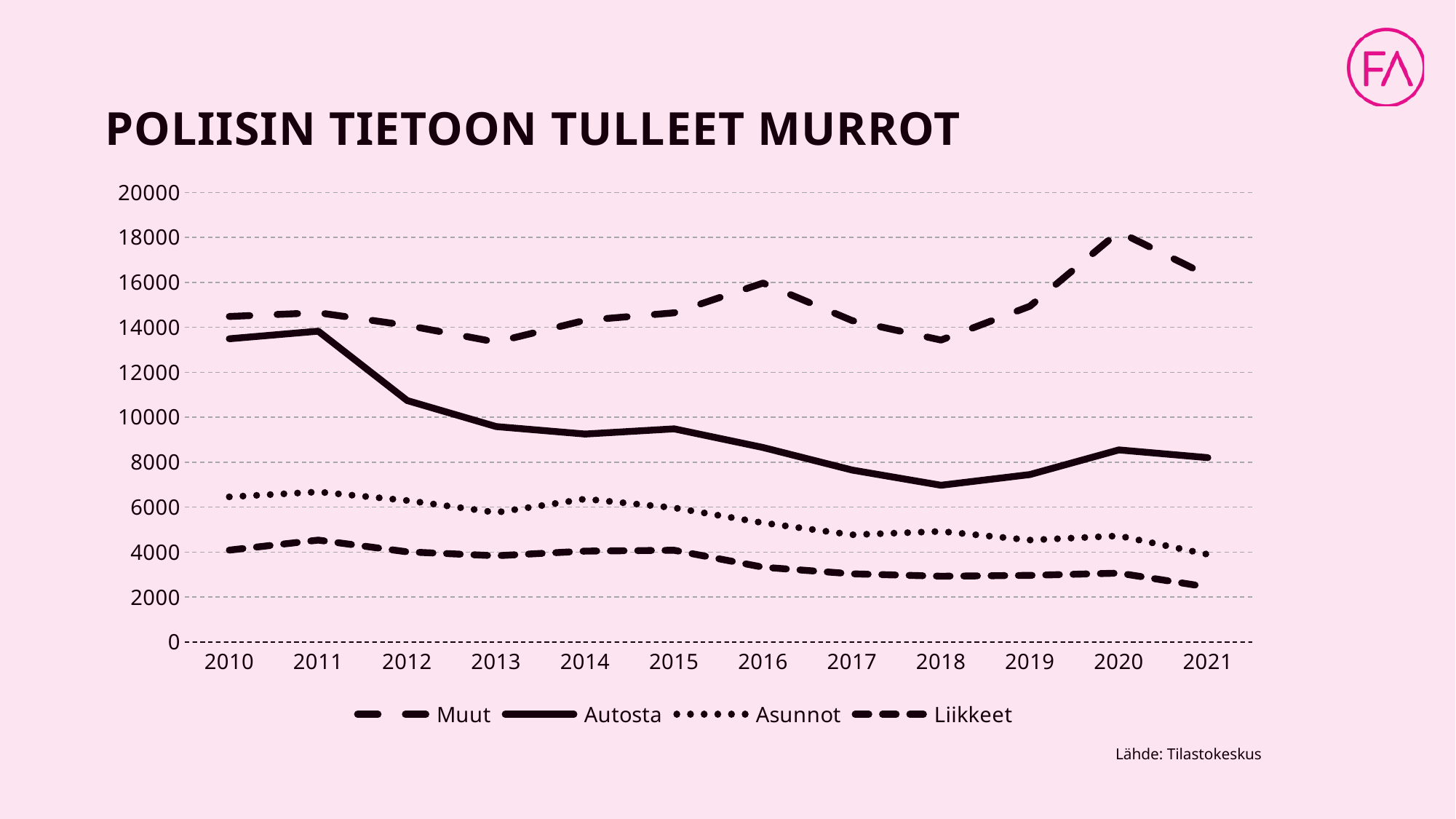
In which year does the Autosta series reach its lowest value? 2018 Which series has the lowest values across the whole period? Liikkeet In which year does the Muut series reach its highest value? 2020 How many series does the legend list? 4 Is the value for Liikkeet in 2021 greater or less than 4000? less What kind of chart is shown on the slide? line chart Which is larger in 2015, Asunnot or Liikkeet? Asunnot Which series has the highest values across the whole period? Muut Is the value for Muut in 2020 greater or less than 16000? greater Does the Autosta series rise or fall from 2010 to 2021? fall Is the value for Autosta in 2010 greater or less than 12000? greater How many years are plotted along the x axis? 12